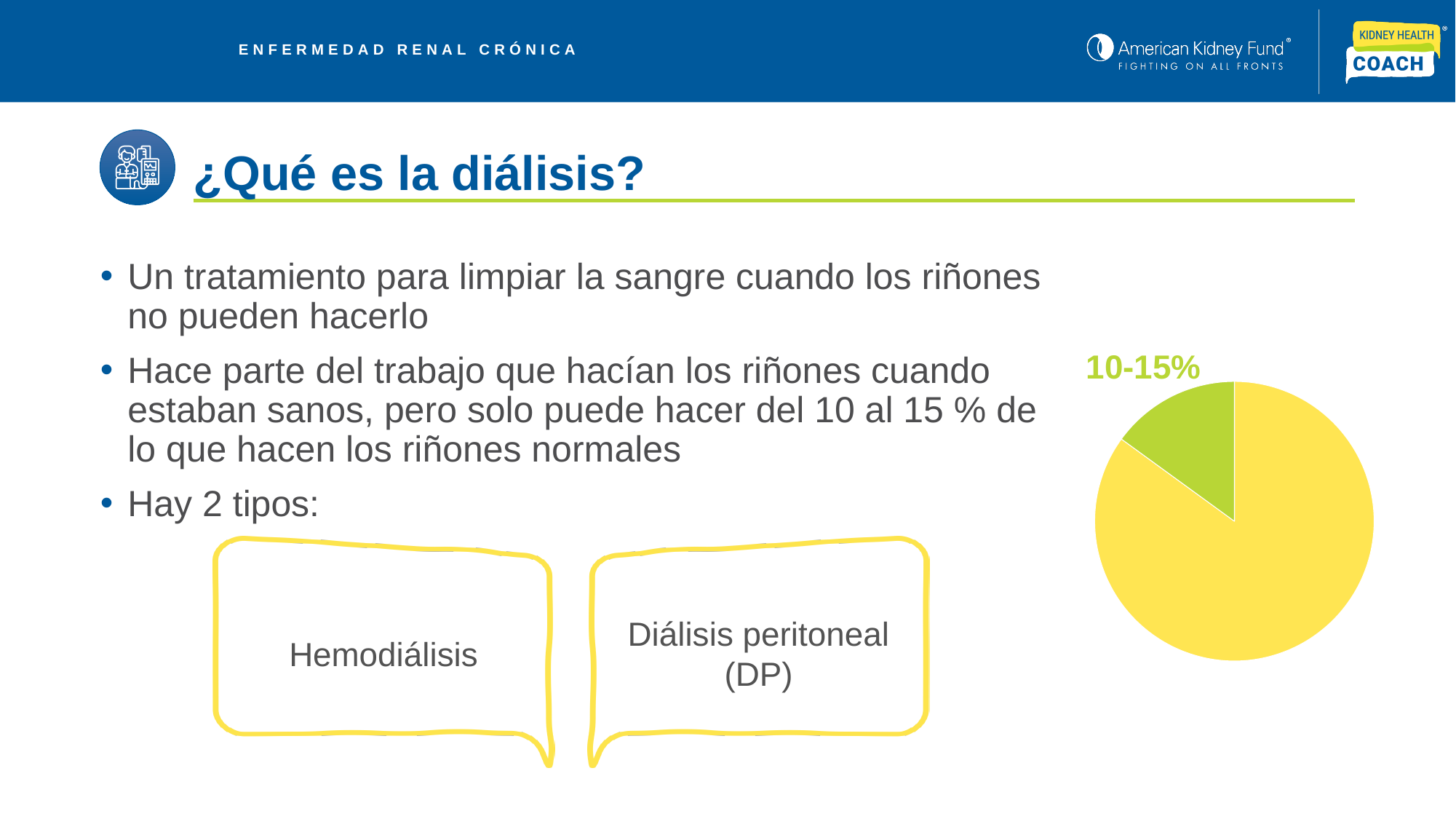
What kind of chart is shown on the right side of the slide? pie chart What label is printed next to the small green slice of the pie chart? 10-15% How many slices does the pie chart have? 2 Which slice of the pie chart is larger, the yellow one or the green one? the yellow one Which slice of the pie chart is the smallest? the green slice (10-15%) What share of the pie does the green slice represent, according to its label? 10-15% Does the pie chart include a legend? No What colour is the slice labelled 10-15% in the pie chart? green